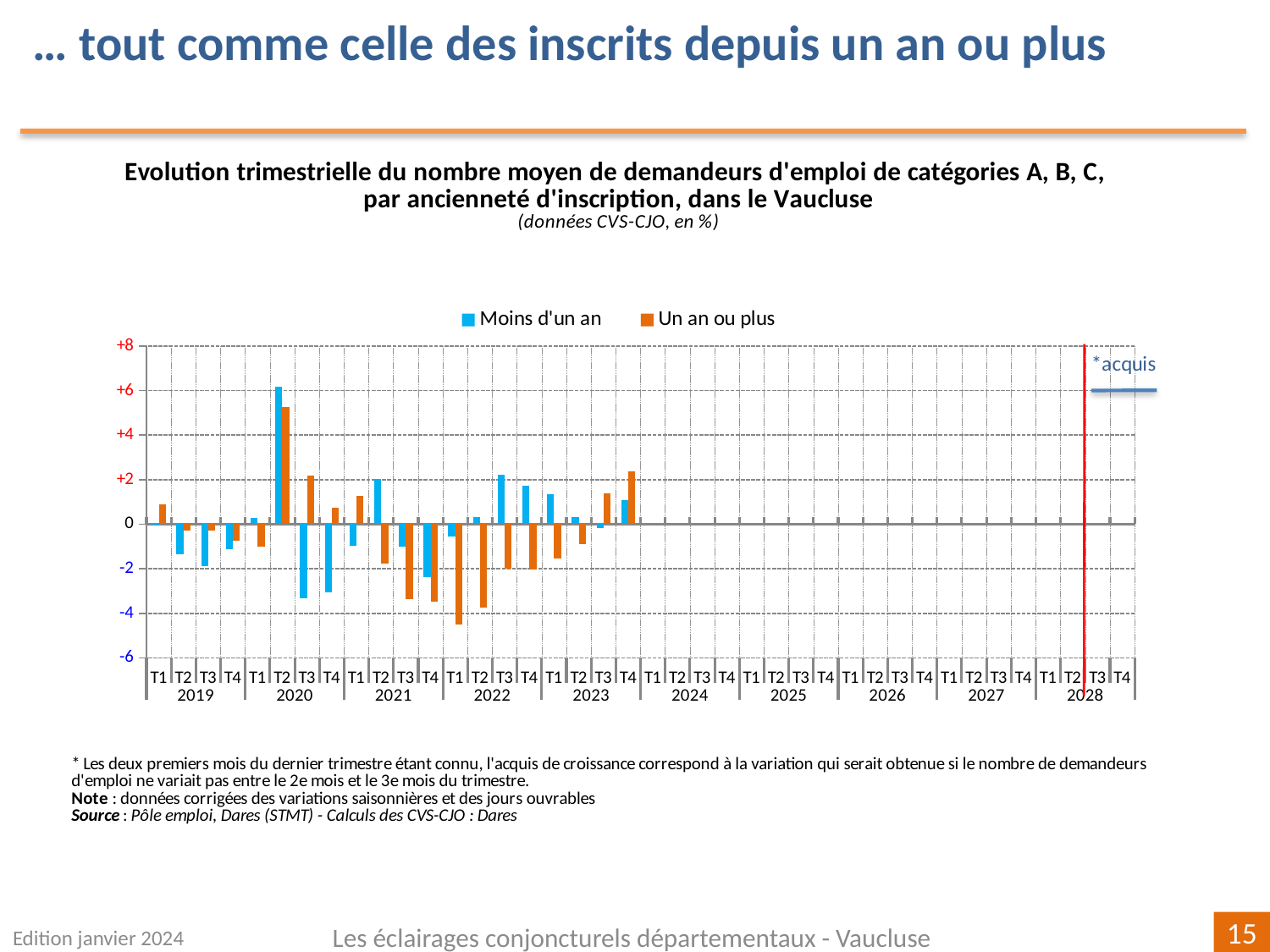
Which series is drawn in orange? Un an ou plus Is the 'Moins d'un an' value for T2 2020 greater or less than +4? greater Is the 'Moins d'un an' value for T3 2020 greater or less than -2? less Is the 'Un an ou plus' value for T3 2021 greater or less than -2? less How many series does the legend list? 2 In which quarter does the 'Un an ou plus' series reach its lowest value? T1 2022 How many years are labelled along the x axis? 10 In T2 2020, which series has the larger value, 'Moins d'un an' or 'Un an ou plus'? Moins d'un an What are the two series named in the legend? Moins d'un an; Un an ou plus What kind of chart is shown on the slide? bar chart In which quarter does the 'Moins d'un an' series reach its highest value? T2 2020